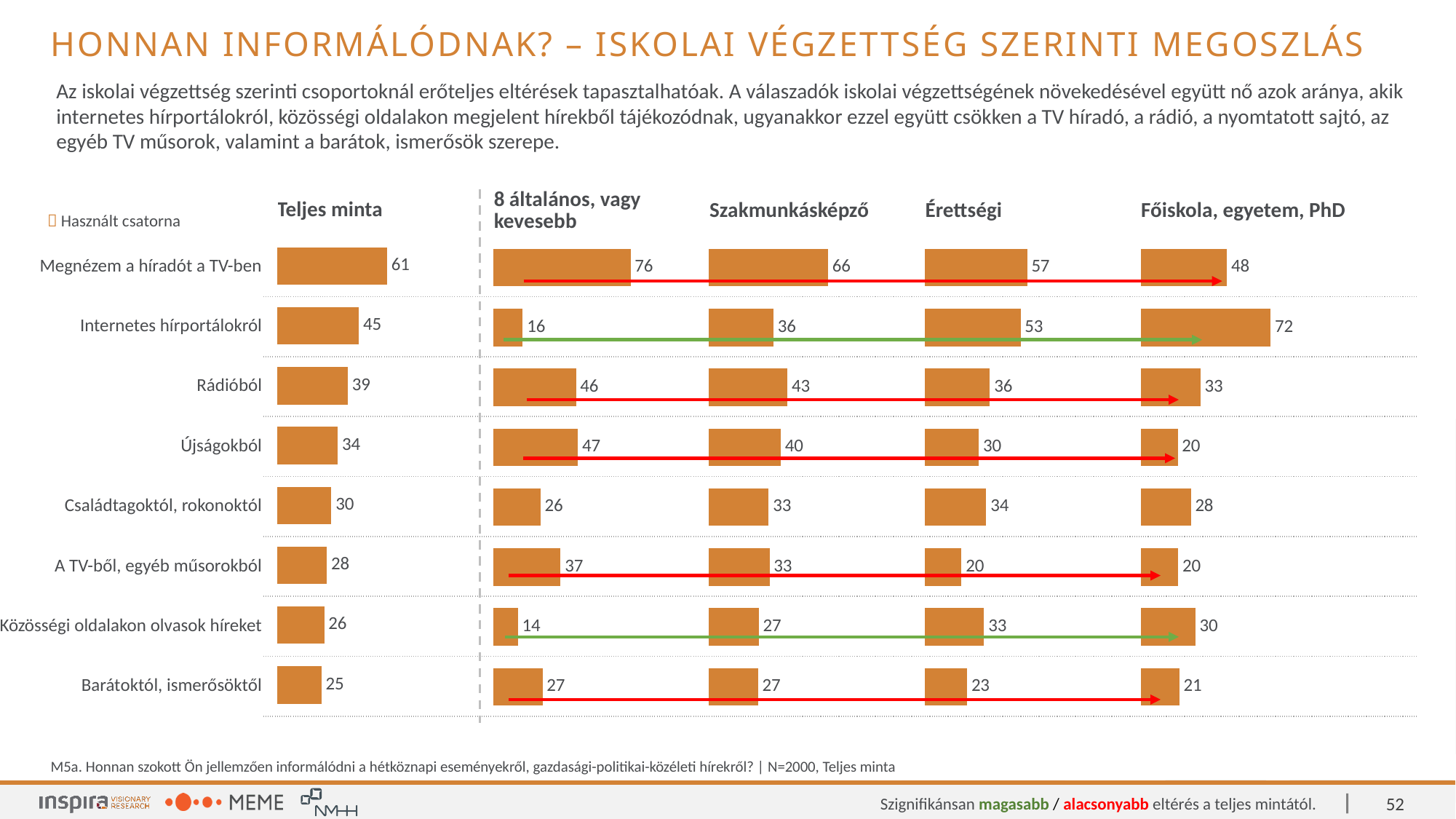
Across the charts from "8 általános, vagy kevesebb" to "Főiskola, egyetem, PhD", do the values for "Megnézem a híradót a TV-ben" rise or fall? Fall In the "Szakmunkásképző" chart, which is larger: the value for "Rádióból" or the value for "Újságokból"? Rádióból How many categories are shown in the "Teljes minta" chart? 8 In the "Teljes minta" chart, what is the difference between the values for "Rádióból" and "Barátoktól, ismerősöktől"? 14 What is the difference between the "Internetes hírportálokról" values in the "Főiskola, egyetem, PhD" chart and the "8 általános, vagy kevesebb" chart? 56 In the "Főiskola, egyetem, PhD" chart, which category has the highest value? Internetes hírportálokról In the "Érettségi" chart, what is the value for "Közösségi oldalakon olvasok híreket"? 33 In the "Teljes minta" chart, what is the value for "Megnézem a híradót a TV-ben"? 61 In the "Főiskola, egyetem, PhD" chart, what is the value for "Internetes hírportálokról"? 72 In the "8 általános, vagy kevesebb" chart, which category has the highest value? Megnézem a híradót a TV-ben What kind of chart is used to show the "Teljes minta" values? Bar chart In the "8 általános, vagy kevesebb" chart, which category has the lowest value? Közösségi oldalakon olvasok híreket